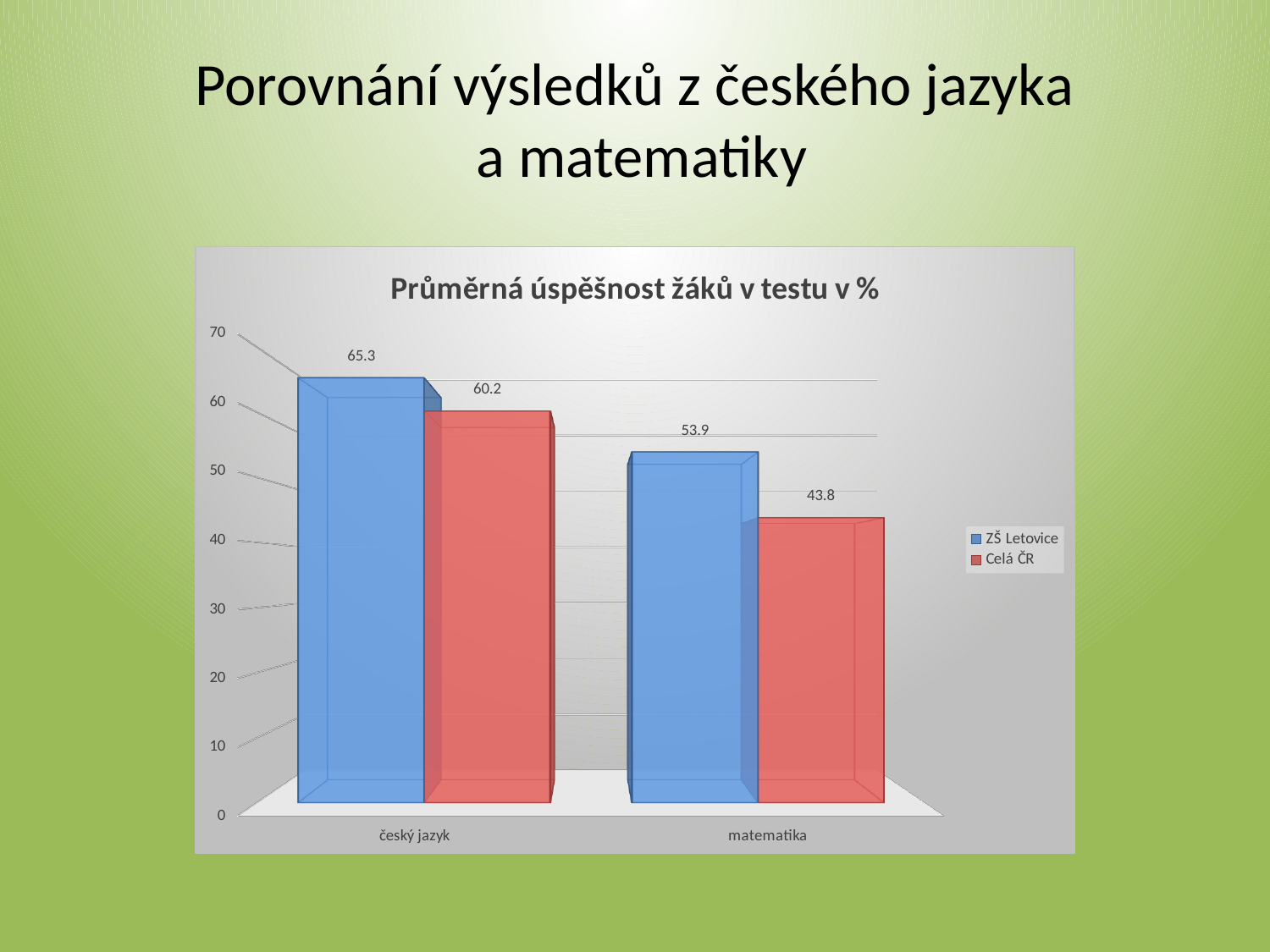
What is the title of the chart? Průměrná úspěšnost žáků v testu v % What is the value for Celá ČR in matematika? 43.8 Which category has the lowest value for Celá ČR? matematika What is the value for ZŠ Letovice in český jazyk? 65.3 Which category has the highest value for ZŠ Letovice? český jazyk How many categories are shown on the x axis? 2 How many series does the legend list? 2 Which is larger in český jazyk, ZŠ Letovice or Celá ČR? ZŠ Letovice What is the value for Celá ČR in český jazyk? 60.2 What is the difference between ZŠ Letovice and Celá ČR in český jazyk? 5.1 What is the value for ZŠ Letovice in matematika? 53.9 What is the difference between ZŠ Letovice and Celá ČR in matematika? 10.1